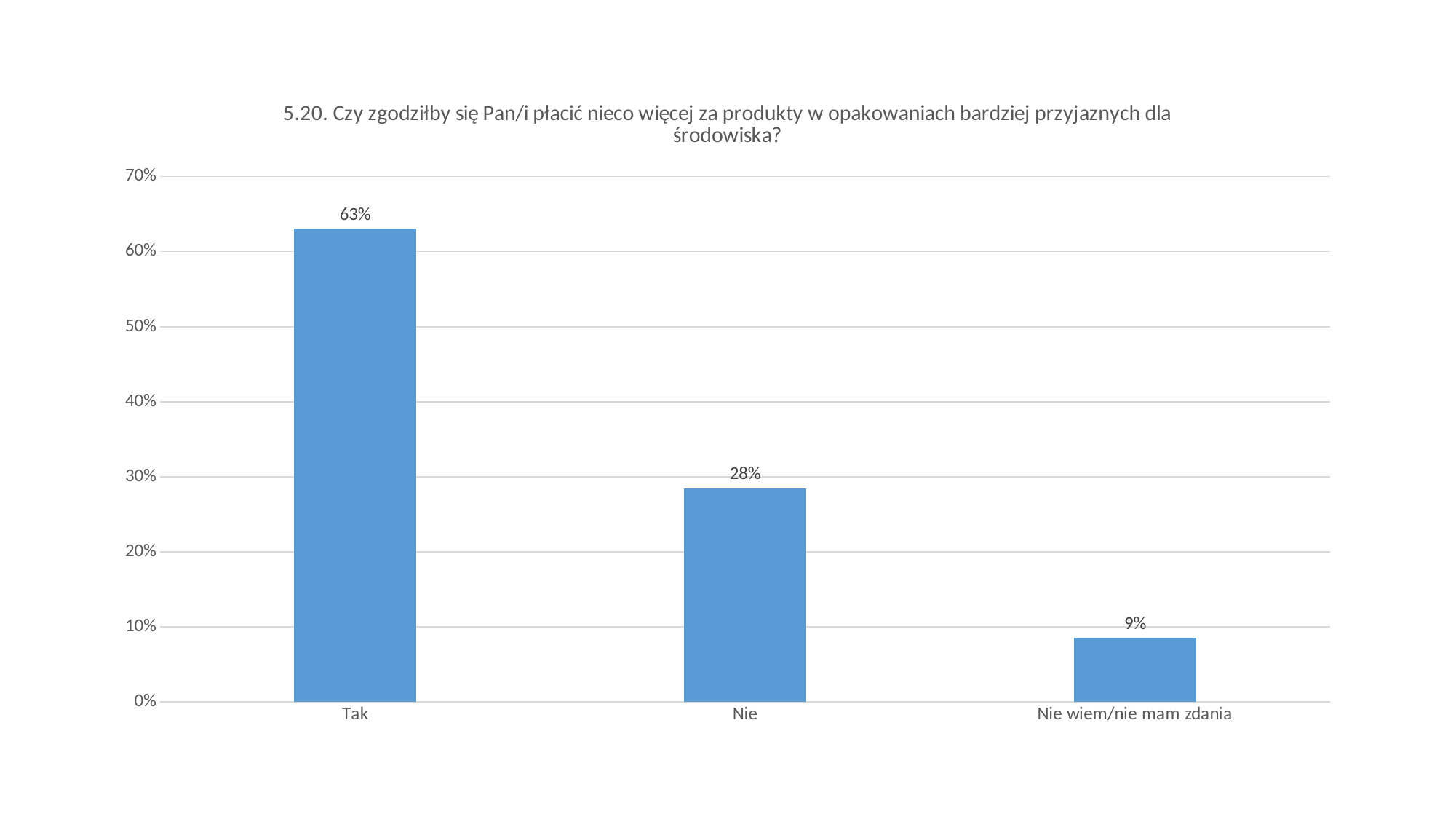
Which is larger, the value for "Nie" or the value for "Nie wiem/nie mam zdania"? Nie What is the value for "Nie wiem/nie mam zdania"? 9% Which category has the lowest value? Nie wiem/nie mam zdania What is the value for "Tak"? 63% How many categories are shown on the x axis? 3 Do the values rise or fall from left to right along the x axis? Fall What is the difference between the values for "Nie" and "Nie wiem/nie mam zdania"? 19% What is the difference between the values for "Tak" and "Nie"? 35% What is the value for "Nie"? 28% What kind of chart is shown on the slide? Bar chart Which category has the highest value? Tak Is the value for "Nie" greater or less than 30%? less